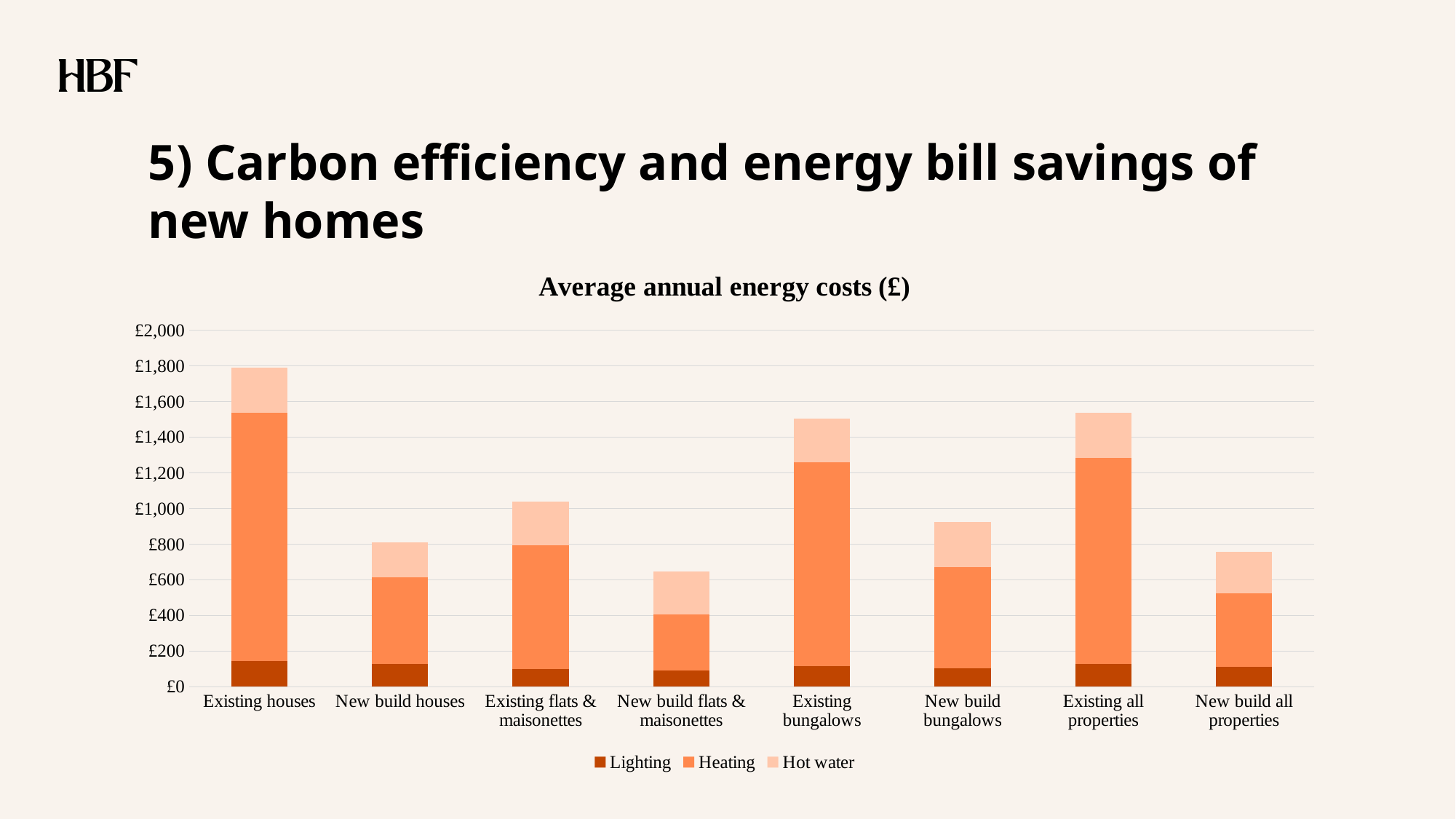
Which has a higher total average annual energy cost: Existing all properties or New build all properties? Existing all properties What is the title of the chart? Average annual energy costs (£) How many series does the legend list? 3 Which category has the highest total average annual energy cost? Existing houses Is the total average annual energy cost for New build flats & maisonettes greater or less than £800? less Which category has the lowest total average annual energy cost? New build flats & maisonettes Is the total average annual energy cost for Existing bungalows greater or less than £1,400? greater Which series are listed in the legend? Lighting, Heating, Hot water Which has a higher total average annual energy cost: Existing flats & maisonettes or New build bungalows? Existing flats & maisonettes Is the total average annual energy cost for Existing houses greater or less than £1,600? greater What type of chart is shown on the slide? Stacked bar chart How many property categories are shown on the x axis? 8